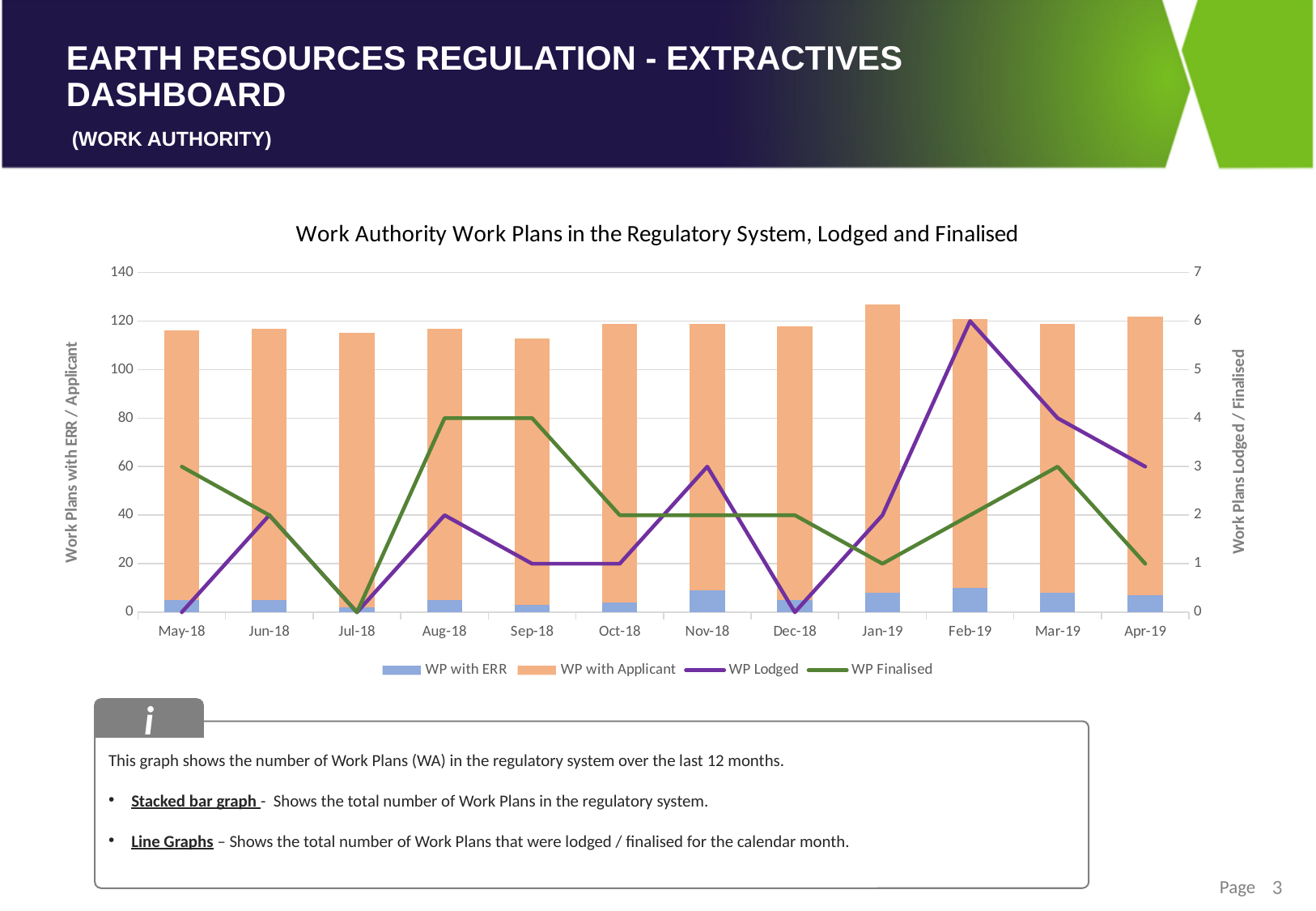
Which is larger in May-18, WP Lodged or WP Finalised? WP Finalised What is the value of WP Lodged for Nov-18? 3 What is the title of the chart? Work Authority Work Plans in the Regulatory System, Lodged and Finalised What is the difference between WP Lodged and WP Finalised in Feb-19? 4 Is the total stacked bar value for Jan-19 greater or less than 120? greater Does the WP Lodged line rise or fall from Feb-19 to Apr-19? fall In which month is WP Lodged highest? Feb-19 How many months are shown on the x axis of the chart? 12 How many series does the chart legend list? 4 Is the WP with ERR value for Feb-19 greater or less than 20? less What is the value of WP Lodged for Feb-19? 6 What is the value of WP Finalised for Aug-18? 4